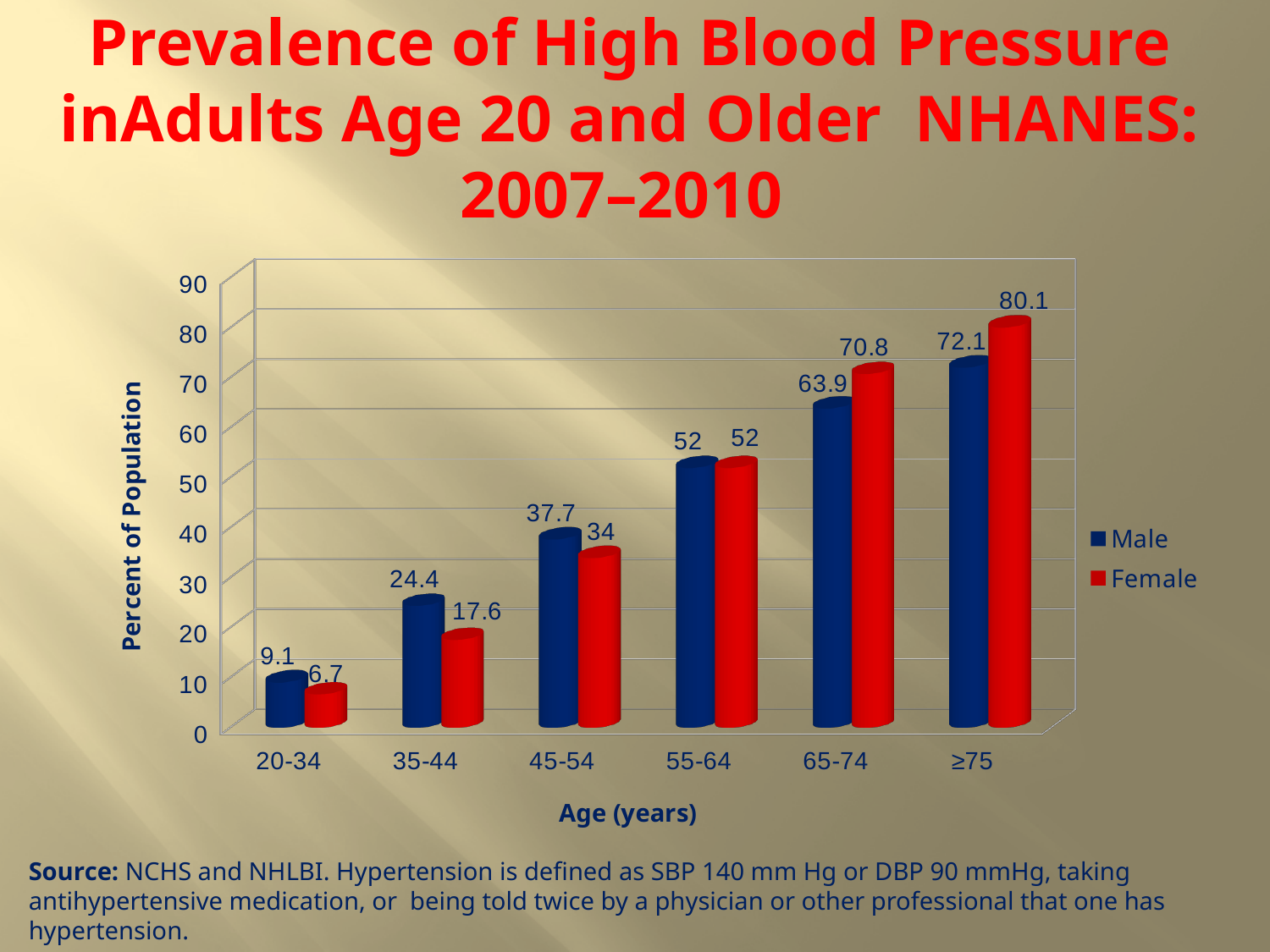
Which is larger for the 35-44 age group, the Male value or the Female value? Male What is the Male value for the 45-54 age group? 37.7 How many age groups are shown on the x axis? 6 Is the Male value for the 55-64 age group greater or less than 50? greater What is the Female value for the 35-44 age group? 17.6 What is the Female value for the ≥75 age group? 80.1 What kind of chart is shown on the slide? bar chart What is the difference between the Male and Female values for the 65-74 age group? 6.9 How many series does the legend list? 2 Do the Female values rise or fall as age increases along the x axis? rise Which age group has the lowest Female value? 20-34 Which age group has the highest Male value? ≥75